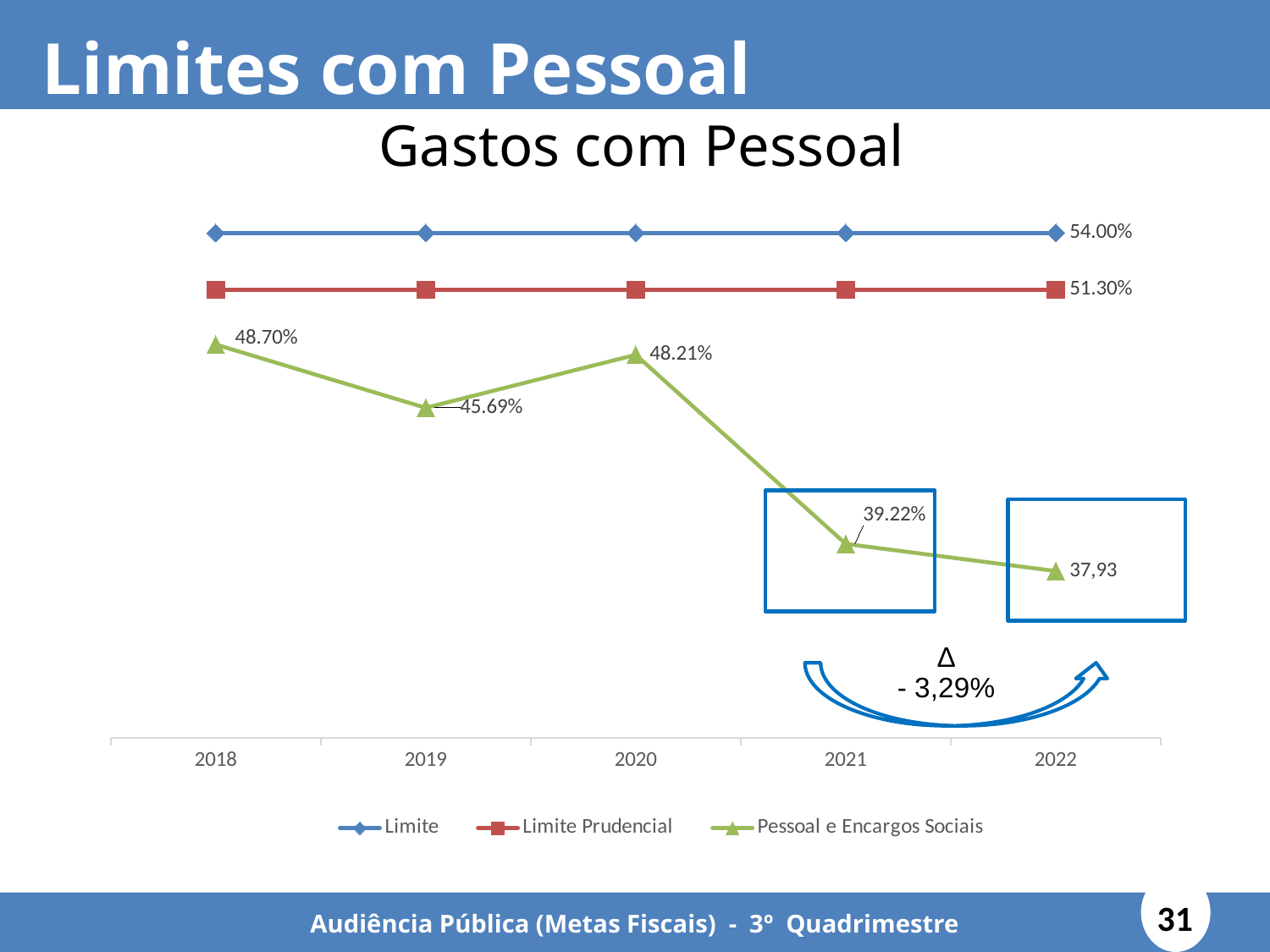
What type of chart is shown on the slide? Line chart What is the value of Pessoal e Encargos Sociais in 2018? 48.70% How many series does the legend list? 3 In which year is Pessoal e Encargos Sociais highest? 2018 What is the value of the Limite series? 54.00% In which year is Pessoal e Encargos Sociais lowest? 2022 What is the value of the Limite Prudencial series? 51.30% What is the title of the chart? Gastos com Pessoal What is the value of Pessoal e Encargos Sociais in 2021? 39.22% How many years are shown on the x axis? 5 What is the difference between the Limite and Limite Prudencial values? 2.70% Is the value of Pessoal e Encargos Sociais higher in 2019 or in 2020? 2020